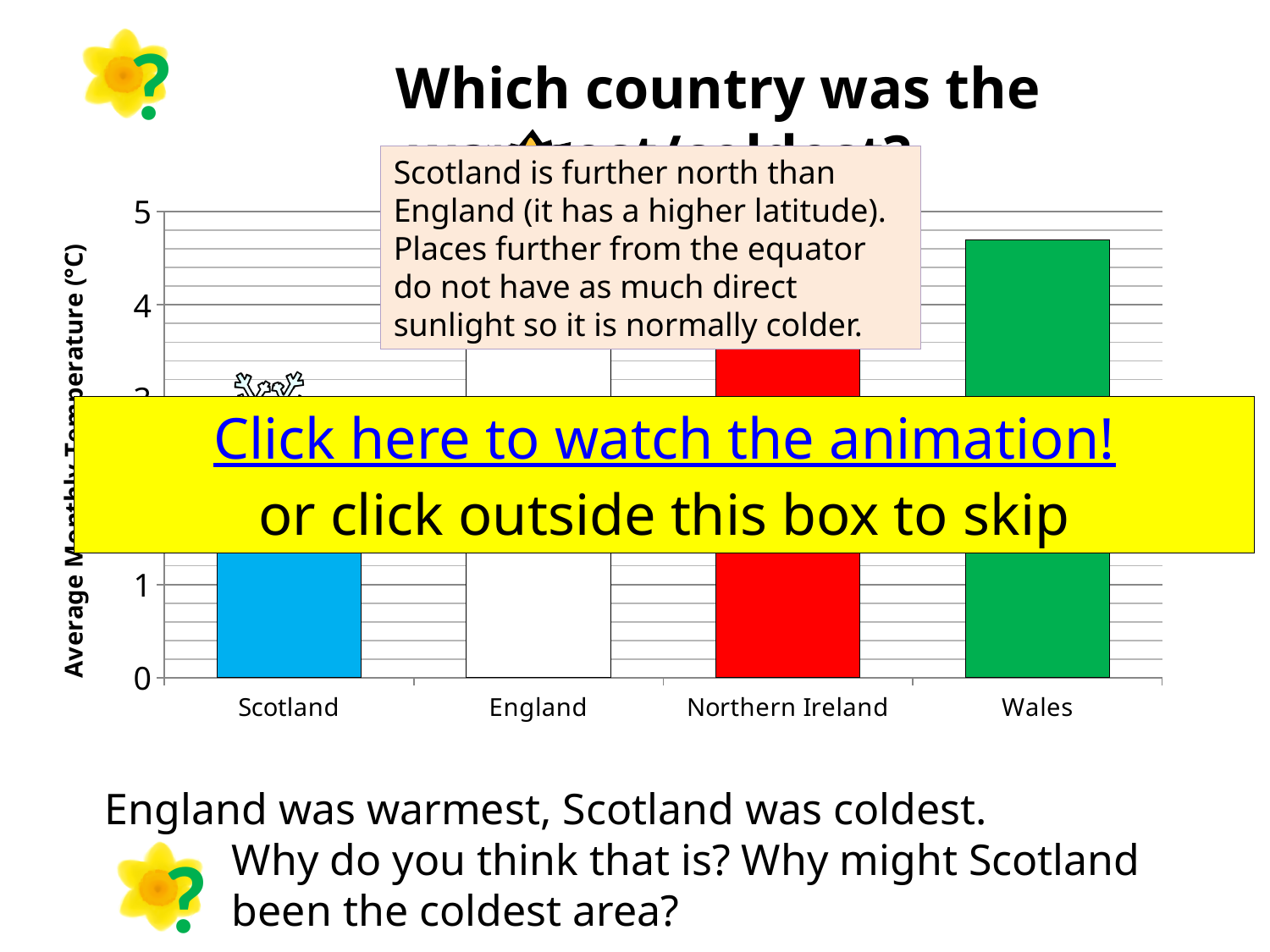
How many countries are shown on the x axis of the chart? 4 Is the value for Northern Ireland greater or less than 3? greater What kind of chart is shown on the slide? bar chart Which country is listed first on the x axis of the chart? Scotland What colour is the bar for Wales? green Is the value for Wales greater or less than 5? less What is the label of the vertical axis of the chart? Average Monthly Temperature (°C) Is the value for Wales greater or less than 4? greater